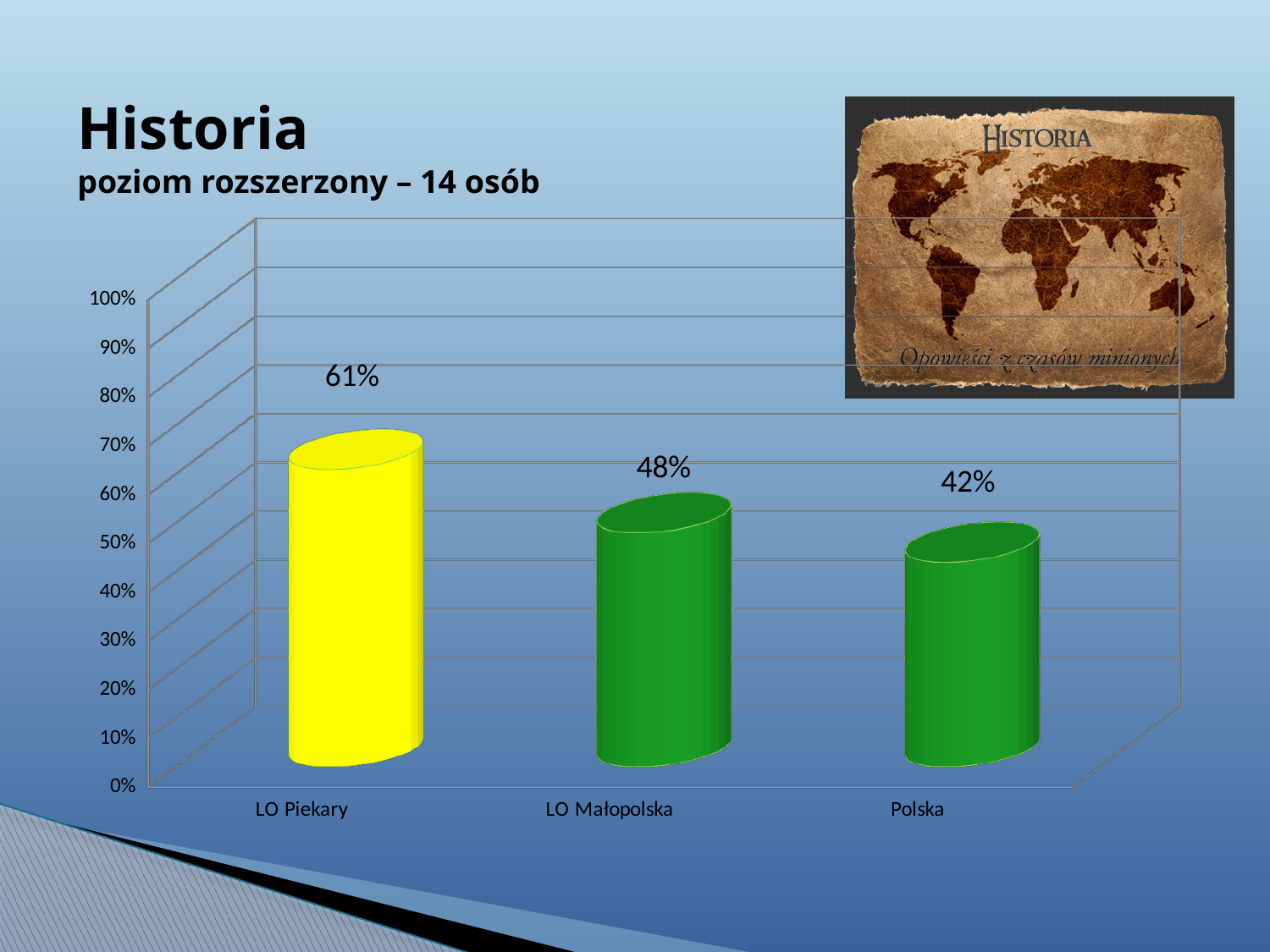
Which category has the highest value? LO Piekary What is the value for Polska? 42% What is the difference between the values for LO Małopolska and Polska? 6% What kind of chart is shown on the slide? bar chart Which category has the lowest value? Polska Is the value for Polska greater or less than 50%? less Do the values rise or fall from left to right across the categories? fall How many categories are shown on the chart? 3 Which is larger, the value for LO Piekary or the value for LO Małopolska? LO Piekary What is the value for LO Piekary? 61% What is the difference between the values for LO Piekary and Polska? 19% What is the value for LO Małopolska? 48%